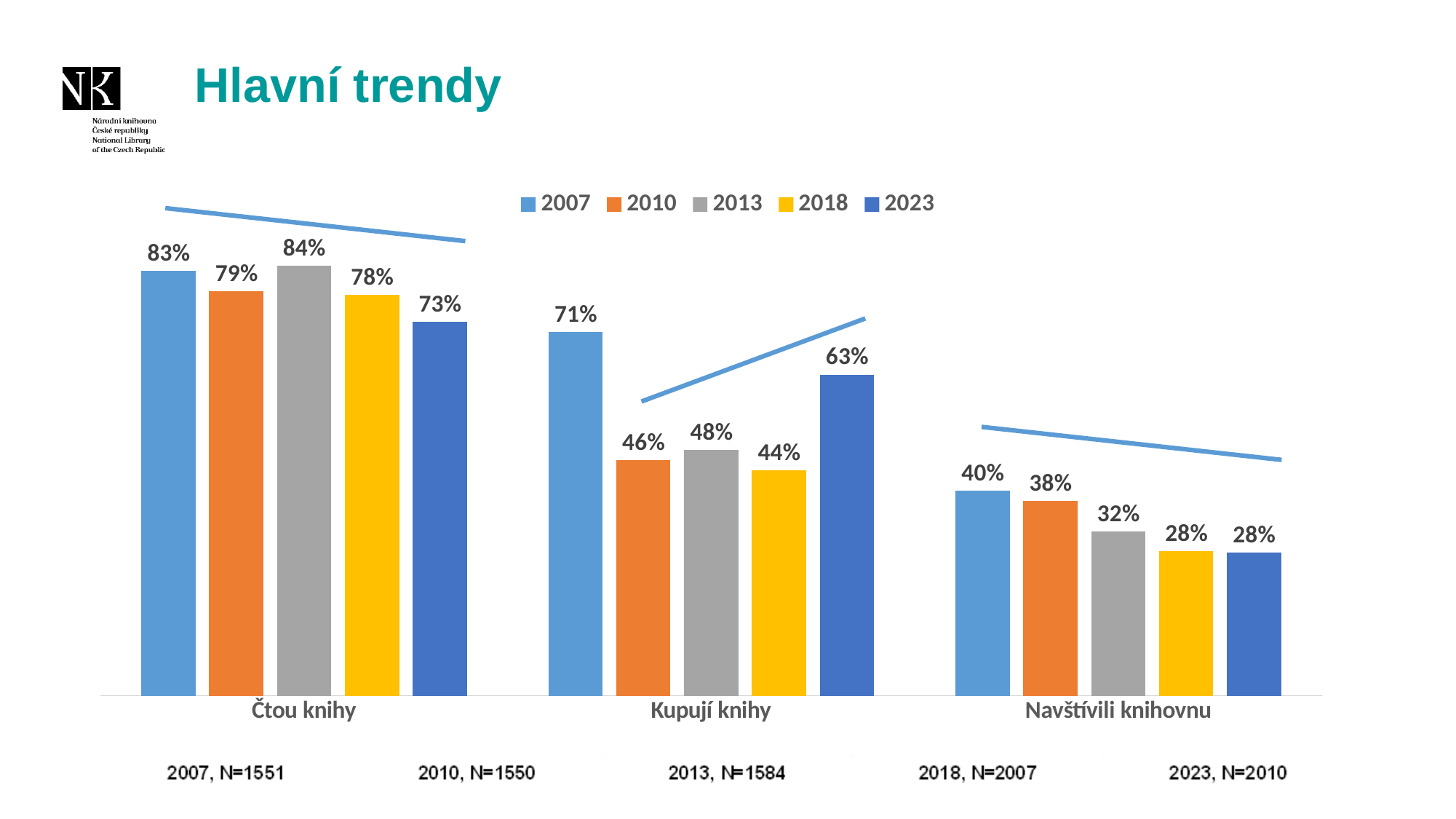
How many series does the legend list? 5 How many categories are shown on the x axis? 3 Which year has the highest value in the "Čtou knihy" category? 2013 Which year has the lowest value in the "Kupují knihy" category? 2018 What is the value for 2023 in the "Kupují knihy" category? 63% What is the title of the slide? Hlavní trendy What is the difference between the 2007 and 2023 values in the "Navštívili knihovnu" category? 12% What is the value for 2013 in the "Navštívili knihovnu" category? 32% Which is larger in the "Kupují knihy" category: the value for 2007 or the value for 2023? 2007 Do the values in the "Navštívili knihovnu" category rise or fall from 2007 to 2023? Fall What kind of chart is shown on the slide? Bar chart What is the value for 2007 in the "Čtou knihy" category? 83%